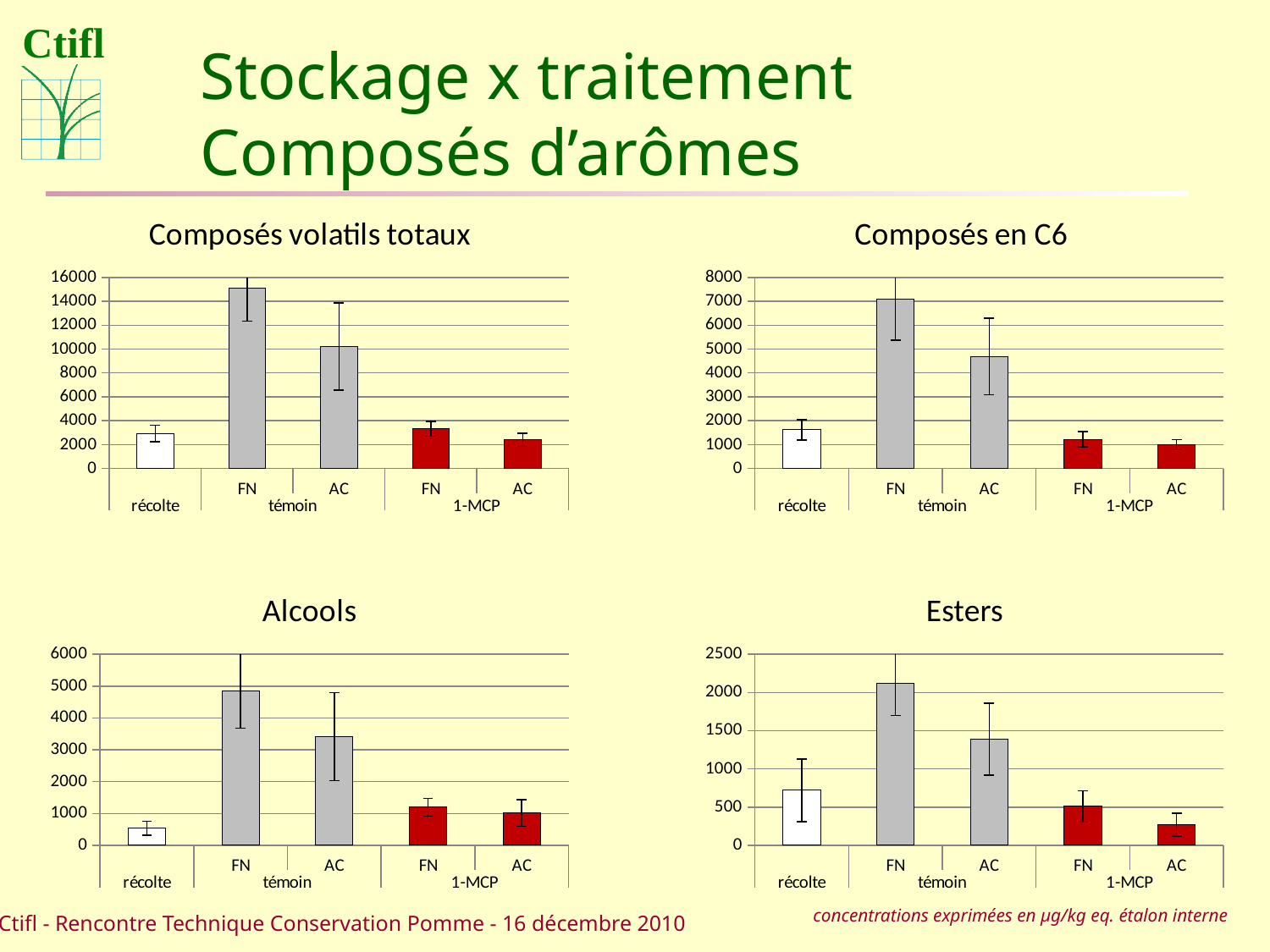
In the "Esters" chart, which bar is the lowest? 1-MCP AC In the "Alcools" chart, which is larger, témoin FN or témoin AC? témoin FN In the "Composés volatils totaux" chart, which bar is the highest? témoin FN What kind of chart is "Composés volatils totaux"? bar chart In the "Composés en C6" chart, which is larger, récolte or 1-MCP FN? récolte According to the note at the bottom of the slide, in what unit are the concentrations expressed? µg/kg eq. étalon interne In the "Alcools" chart, is the value for récolte greater or less than 1000? less In the "Composés volatils totaux" chart, is the value for témoin FN greater or less than 14000? greater How many bars are plotted in the "Alcools" chart? 5 In the "Composés en C6" chart, is the value for témoin AC greater or less than 4000? greater How many charts are shown on the slide? 4